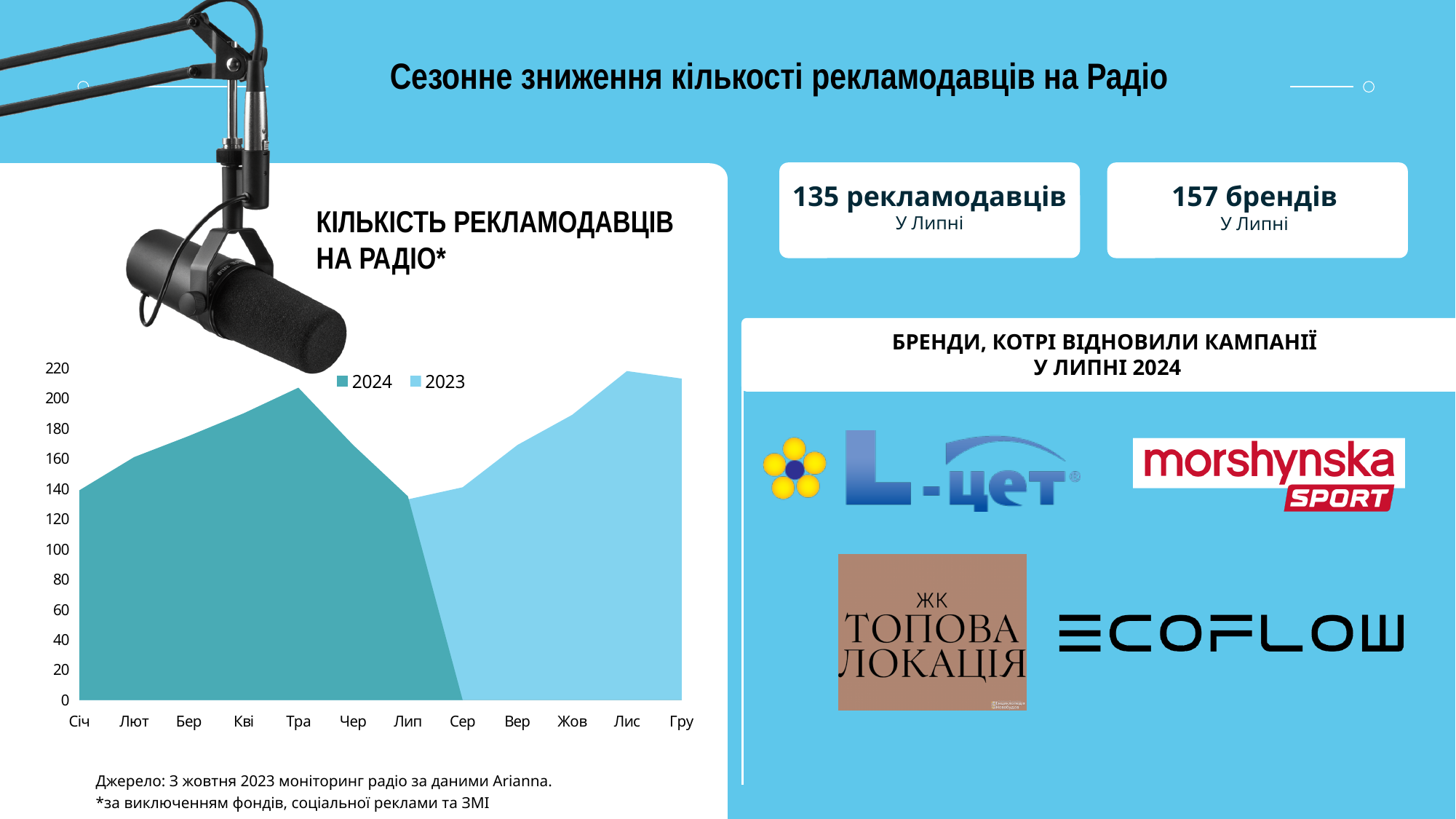
Is the 2024 value for Тра greater or less than 180? greater Which is larger for the 2024 series: the value for Тра or the value for Січ? Тра Is the 2024 value for Січ greater or less than 160? less How many series does the chart legend list? 2 Is the 2024 value for Лип greater or less than 160? less How many months are shown on the x axis of the chart? 12 What kind of chart is shown on the slide? area chart In which month does the 2024 series reach its highest value? Тра Which series are listed in the chart legend? 2024 and 2023 What is the title of the chart? КІЛЬКІСТЬ РЕКЛАМОДАВЦІВ НА РАДІО* Does the 2024 series rise or fall from Тра to Лип? fall